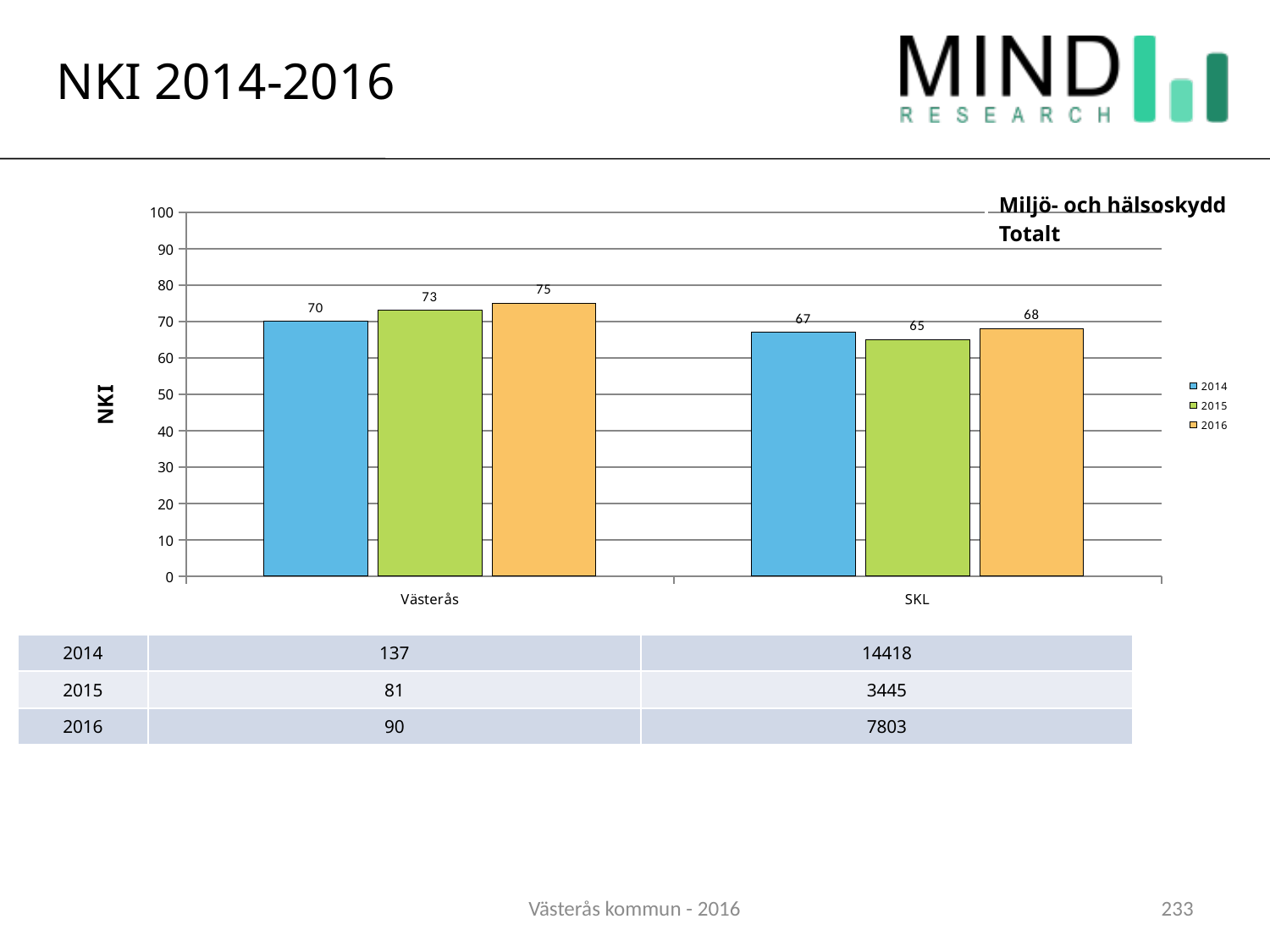
Which year has the lowest NKI value for SKL? 2015 How many series does the chart legend list? 3 Which is larger, the 2014 NKI value for Västerås or for SKL? Västerås What kind of chart is shown on the slide? bar chart Which year has the highest NKI value for Västerås? 2016 What is the difference between the 2016 NKI values for Västerås and SKL? 7 What is the NKI value for Västerås in 2014? 70 What is the NKI value for Västerås in 2016? 75 Do the NKI values for Västerås rise or fall from 2014 to 2016? rise Is the 2015 NKI value for SKL greater or less than 70? less What is the NKI value for SKL in 2015? 65 How many categories are shown on the x axis of the chart? 2